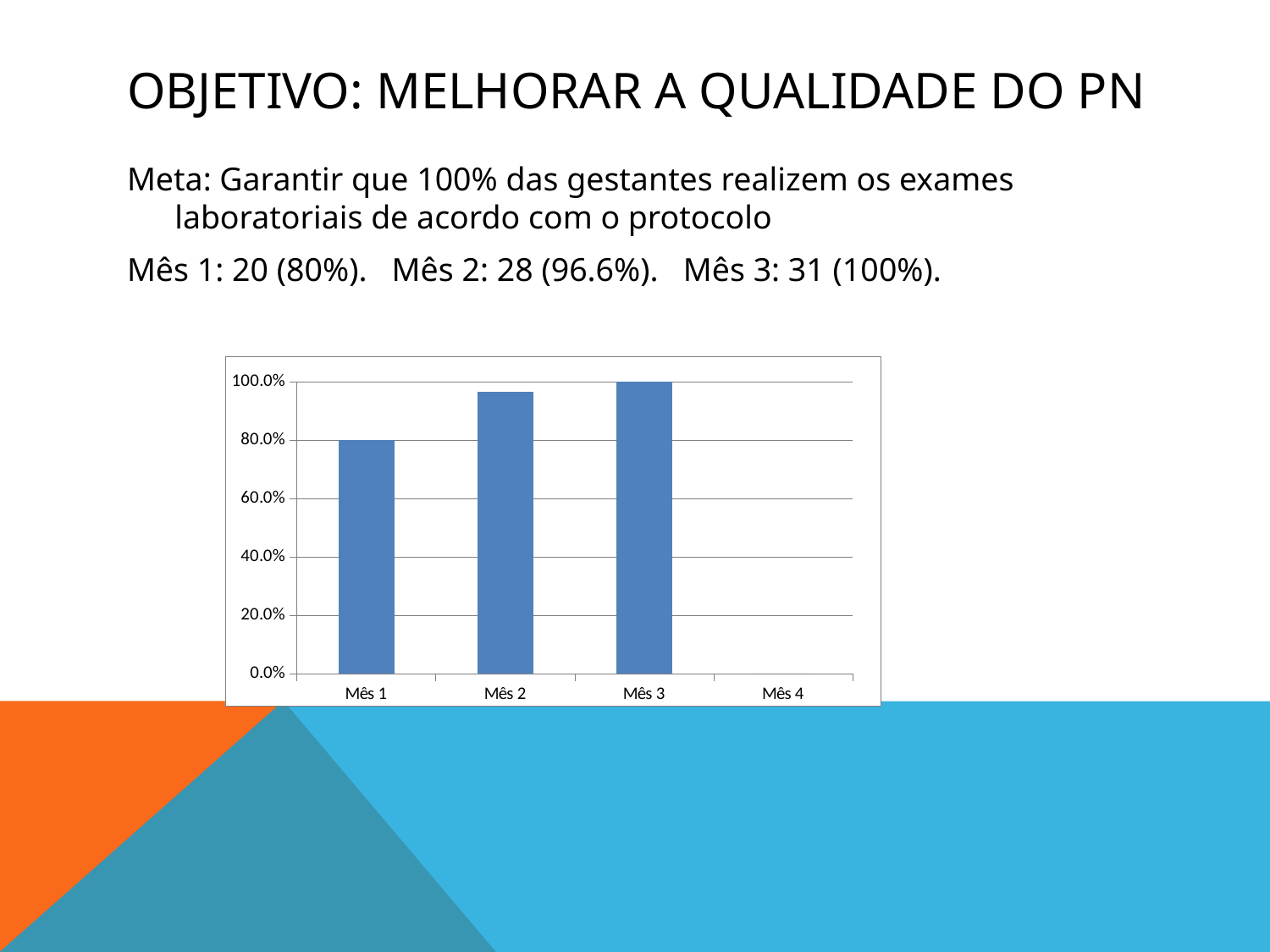
Which month has the highest value in the chart? Mês 3 How many bars are plotted in the chart? 3 Among the months with a bar, which has the lowest value? Mês 1 What type of chart is shown on the slide? Bar chart What is the highest value shown on the y axis of the chart? 100.0% Is the value for Mês 2 greater or less than 80.0%? greater What is the difference between the values for Mês 3 and Mês 1? 20 percentage points Do the values rise or fall from Mês 1 to Mês 3? Rise What is the value for Mês 1 in the chart? 80.0% How many categories are shown on the x axis of the chart? 4 What is the value for Mês 3 in the chart? 100.0% Which is larger, the value for Mês 2 or the value for Mês 1? Mês 2